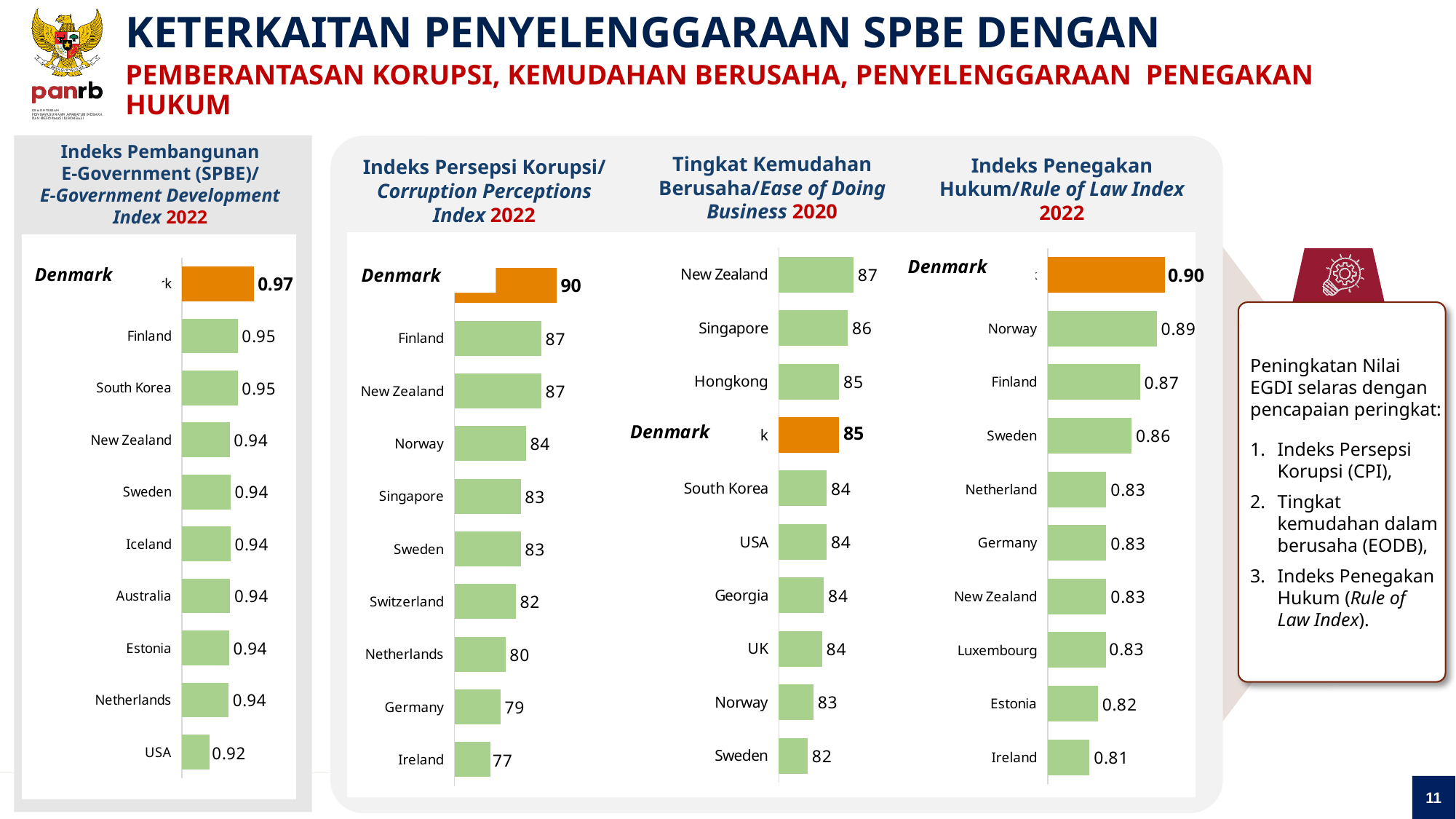
In the Rule of Law Index 2022 chart, what is the difference between Denmark and Ireland? 0.09 In the E-Government Development Index 2022 chart, which country has the lowest value? USA In the Rule of Law Index 2022 chart, what is the value for Sweden? 0.86 What type of chart is the Corruption Perceptions Index 2022 chart? Bar chart How many countries are shown in the Rule of Law Index 2022 chart? 10 In the Ease of Doing Business 2020 chart, which country has the highest value? New Zealand In the Ease of Doing Business 2020 chart, what is the value for Denmark? 85 In the Corruption Perceptions Index 2022 chart, what is the value for Norway? 84 In the Ease of Doing Business 2020 chart, which is larger, the value for Singapore or the value for Sweden? Singapore In the Corruption Perceptions Index 2022 chart, what is the difference between Denmark and Ireland? 13 In the Corruption Perceptions Index 2022 chart, which country has the highest value? Denmark In the E-Government Development Index 2022 chart, what is the value for Denmark? 0.97